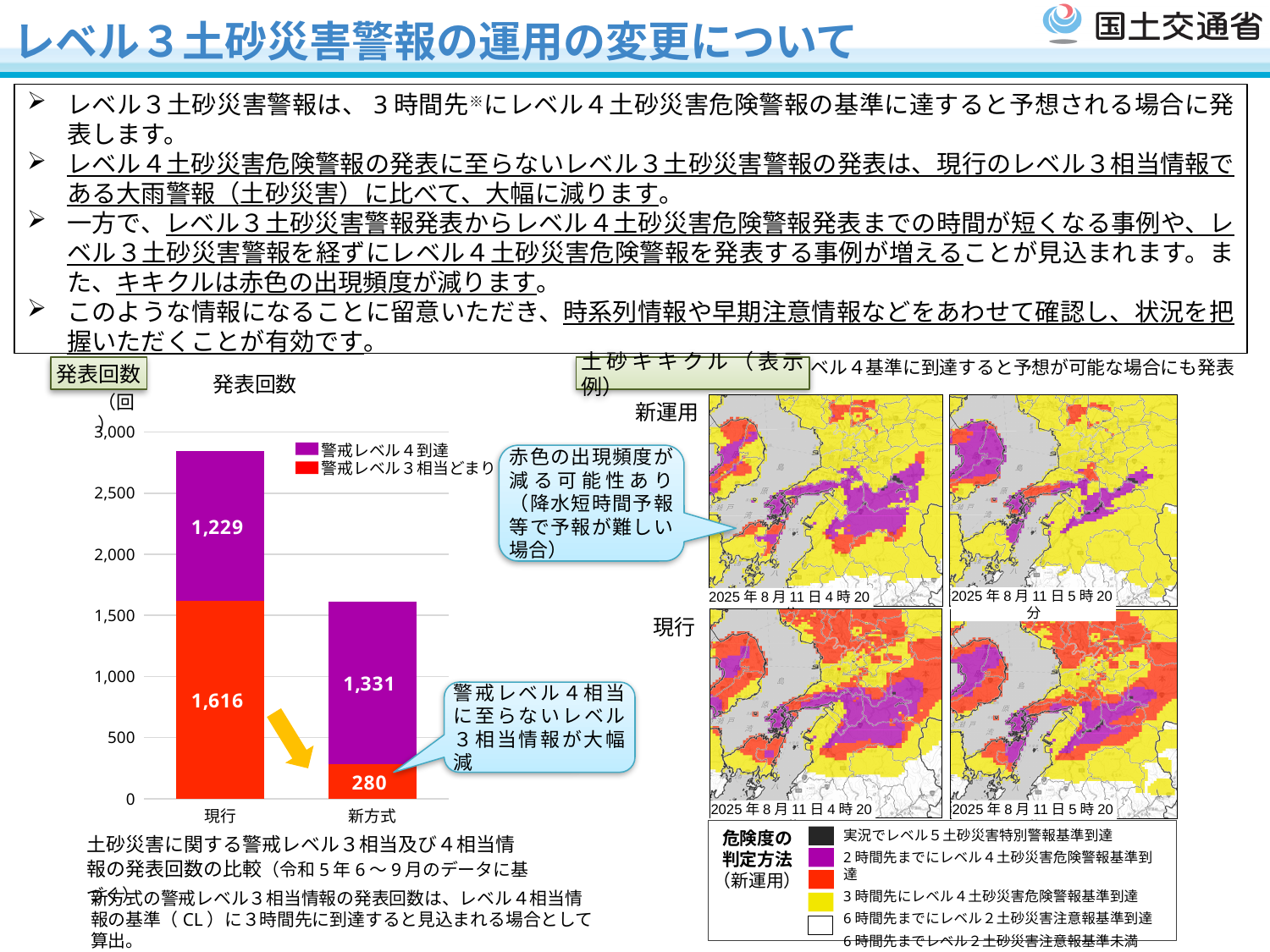
What kind of chart is the 発表回数 chart? bar chart In the 発表回数 chart, what is the difference between the 警戒レベル3相当どまり values for 現行 and 新方式? 1,336 In the 発表回数 chart, what is the value of 警戒レベル3相当どまり for 現行? 1,616 In the 発表回数 chart, what is the total of the stacked bar for 新方式? 1,611 In the 発表回数 chart, what is the value of 警戒レベル4到達 for 現行? 1,229 In the 発表回数 chart, how many categories are shown on the x axis? 2 In the 発表回数 chart, which category has the larger 警戒レベル3相当どまり value, 現行 or 新方式? 現行 In the 発表回数 chart, what is the value of 警戒レベル3相当どまり for 新方式? 280 In the 発表回数 chart, what is the total of the stacked bar for 現行? 2,845 In the 発表回数 chart, what is the value of 警戒レベル4到達 for 新方式? 1,331 In the 発表回数 chart, how many series does the legend list? 2 In the 発表回数 chart, which colour represents 警戒レベル4到達? purple